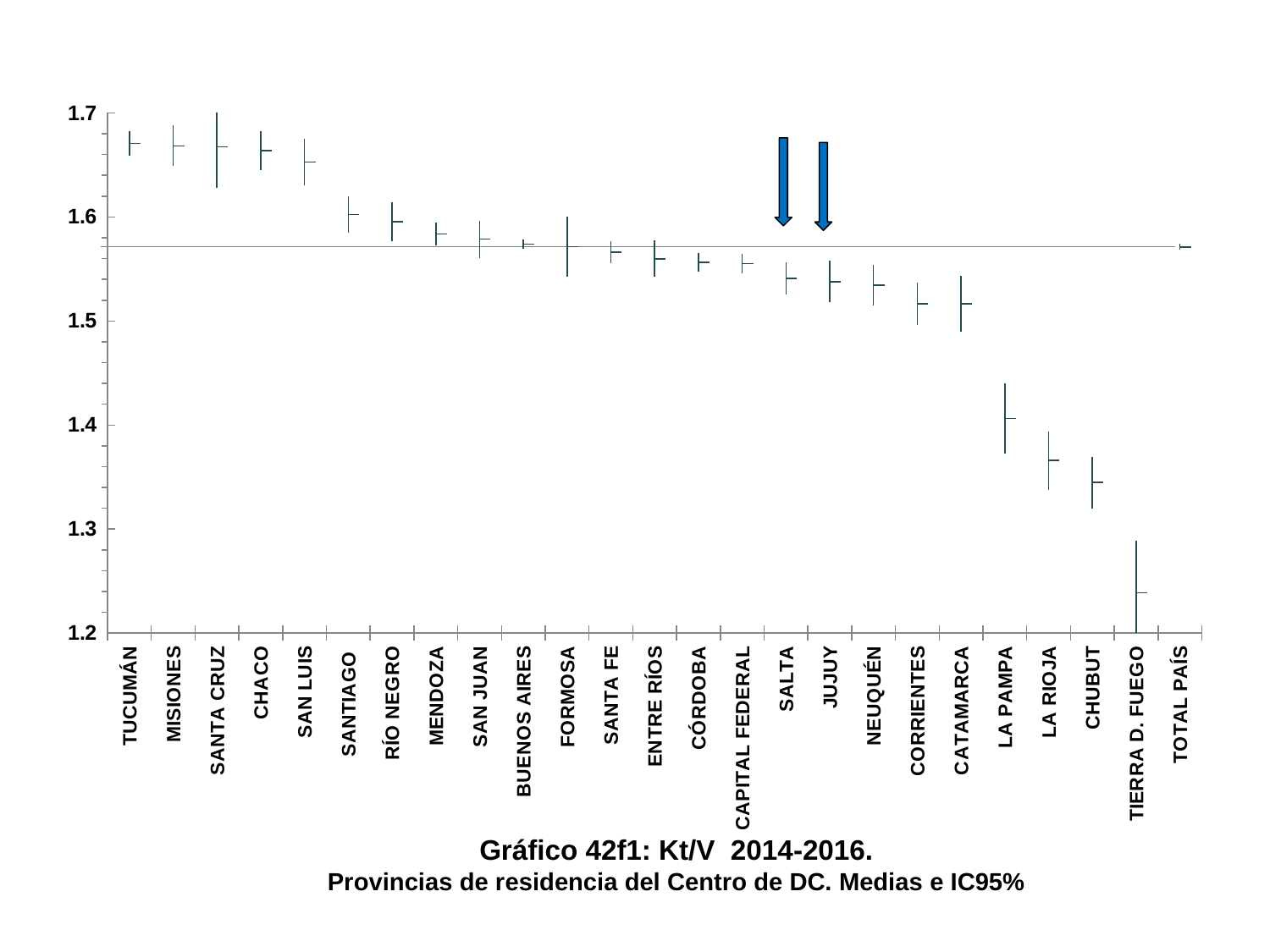
Which province has the lowest Kt/V mean on the chart? TIERRA D. FUEGO Is the Kt/V mean for TIERRA D. FUEGO greater or less than 1.3? less Is the Kt/V mean for SALTA greater or less than 1.6? less Is the Kt/V mean for TUCUMÁN greater or less than 1.6? greater Which has a higher Kt/V mean, TUCUMÁN or CHUBUT? TUCUMÁN How many categories are shown along the x axis, including TOTAL PAÍS? 25 Which has a higher Kt/V mean, SANTIAGO or LA PAMPA? SANTIAGO Do the Kt/V means generally rise or fall from left to right along the x axis? fall What is the title of the chart? Gráfico 42f1: Kt/V 2014-2016. Which two provinces are marked with blue arrows on the chart? SALTA and JUJUY